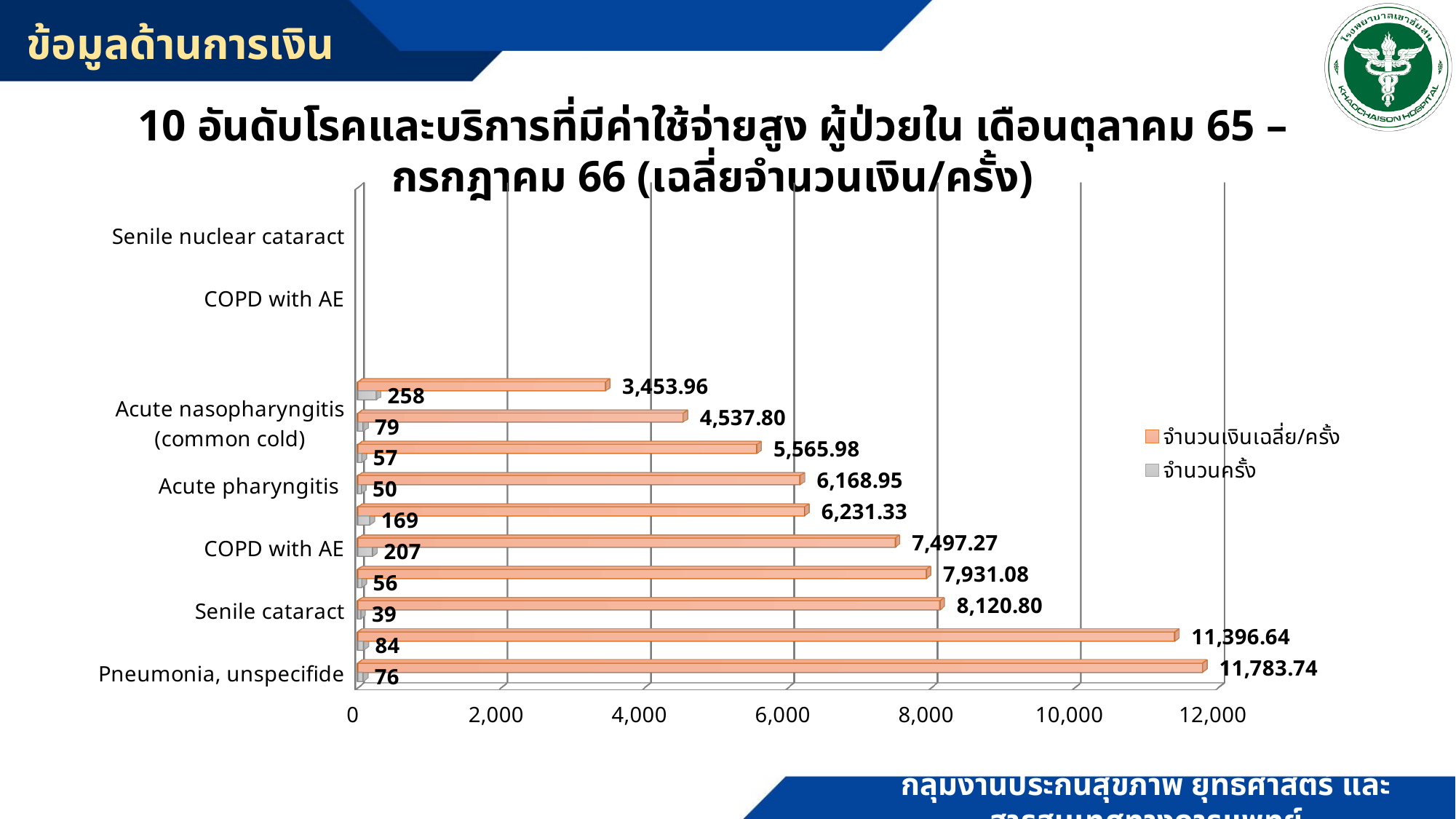
How many orange bars (จำนวนเงินเฉลี่ย/ครั้ง) are plotted in the chart? 10 What is the จำนวนครั้ง value for Pneumonia, unspecifide? 76 What are the two legend entries of the chart? จำนวนเงินเฉลี่ย/ครั้ง and จำนวนครั้ง What is the จำนวนเงินเฉลี่ย/ครั้ง value for Senile cataract? 8,120.80 Which has the larger จำนวนเงินเฉลี่ย/ครั้ง value, Senile cataract or COPD with AE (the lower one, 7,497.27)? Senile cataract What is the largest จำนวนครั้ง value shown in the chart? 258 How many series does the legend list? 2 Which category has the highest จำนวนเงินเฉลี่ย/ครั้ง value? Pneumonia, unspecifide What is the จำนวนเงินเฉลี่ย/ครั้ง value for Pneumonia, unspecifide? 11,783.74 What is the smallest จำนวนเงินเฉลี่ย/ครั้ง value shown in the chart? 3,453.96 What kind of chart is shown on the slide? bar chart What is the จำนวนครั้ง value for Acute pharyngitis? 50